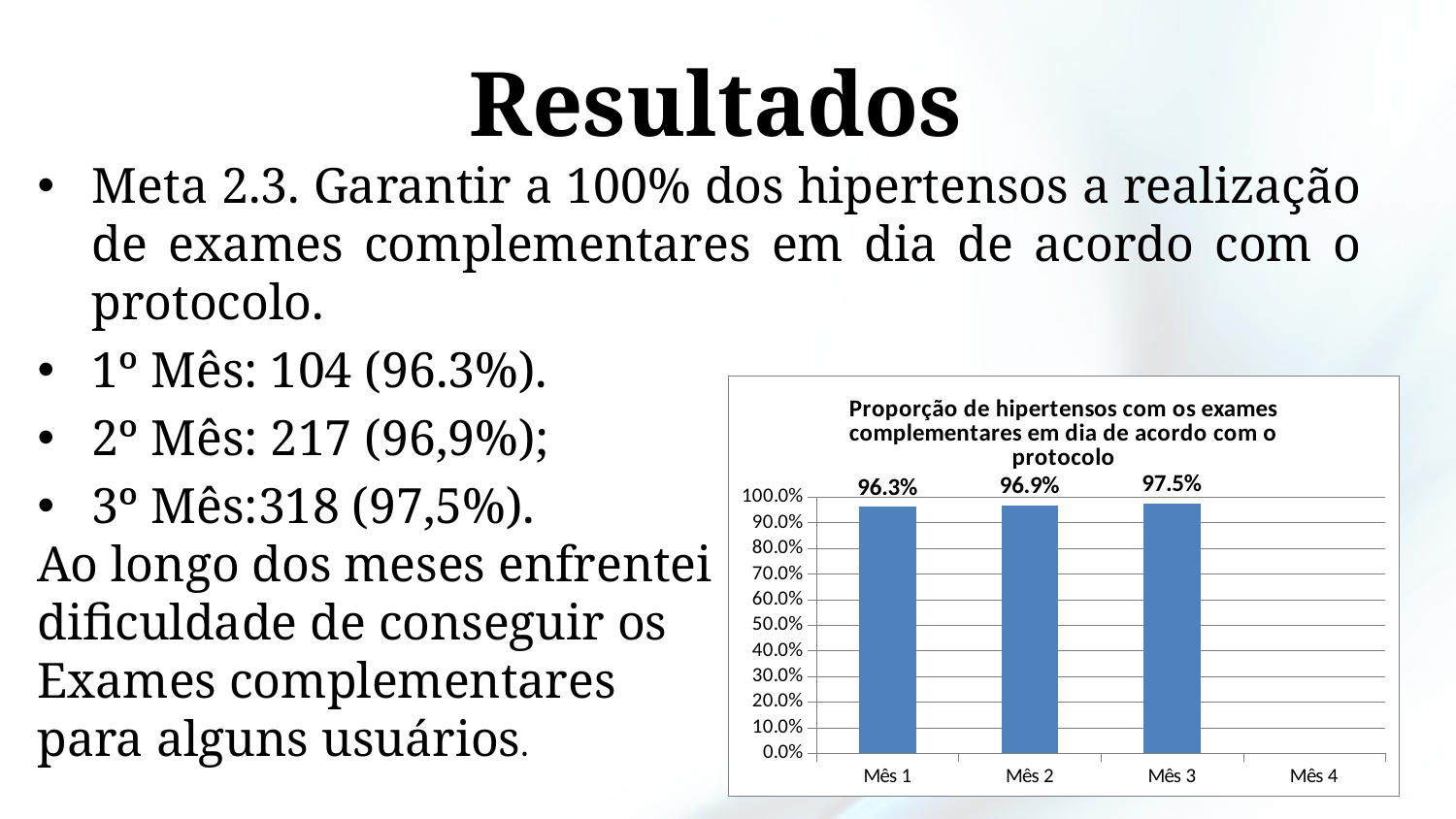
What is the value for Mês 1? 96.3% Which month with a plotted bar has the lowest proportion? Mês 1 What is the difference between the values for Mês 2 and Mês 1? 0.6 percentage points How many months have a bar plotted in the chart? 3 Is the value for Mês 1 greater or less than 90.0%? greater What kind of chart is shown on the slide? Bar chart What is the difference between the values for Mês 3 and Mês 1? 1.2 percentage points Do the values rise or fall from Mês 1 to Mês 3? Rise What is the value for Mês 3? 97.5% Which month has the highest proportion? Mês 3 Which is larger, the value for Mês 2 or the value for Mês 3? Mês 3 What is the value for Mês 2? 96.9%